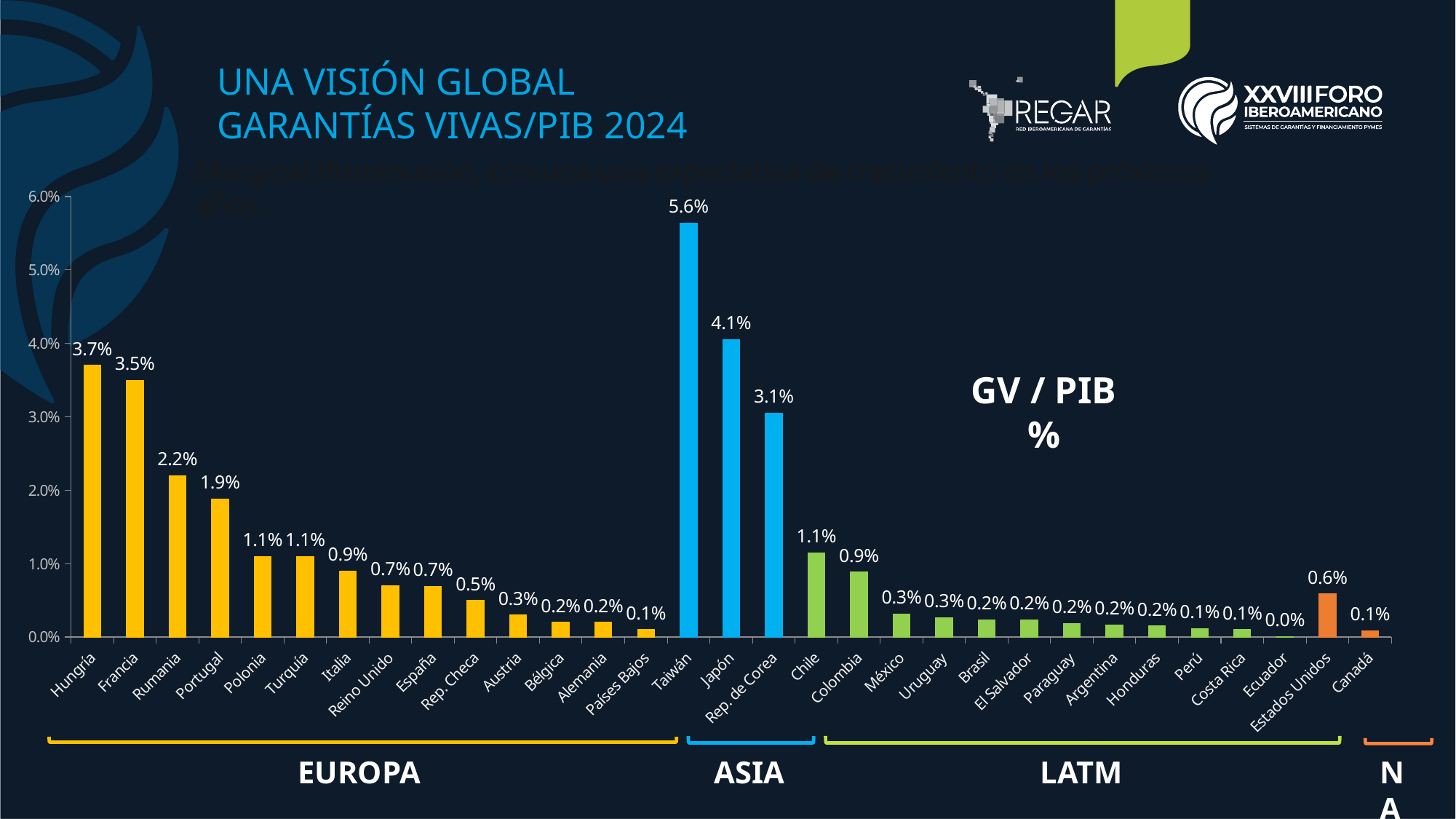
What is the value for Chile? 1.1% Which country has the highest value on the chart? Taiwán Which country has the lowest value on the chart? Ecuador What is the value for Taiwán? 5.6% Is the value for Japón greater or less than 4.0%? greater What is the value for Hungría? 3.7% What kind of chart is shown on the slide? Bar chart What is the value for Estados Unidos? 0.6% How many countries are plotted on the chart? 31 What is the difference between the values for Hungría and Francia? 0.2% Which is larger, the value for Rep. de Corea or the value for Rumania? Rep. de Corea What is the difference between the values for Taiwán and Japón? 1.5%